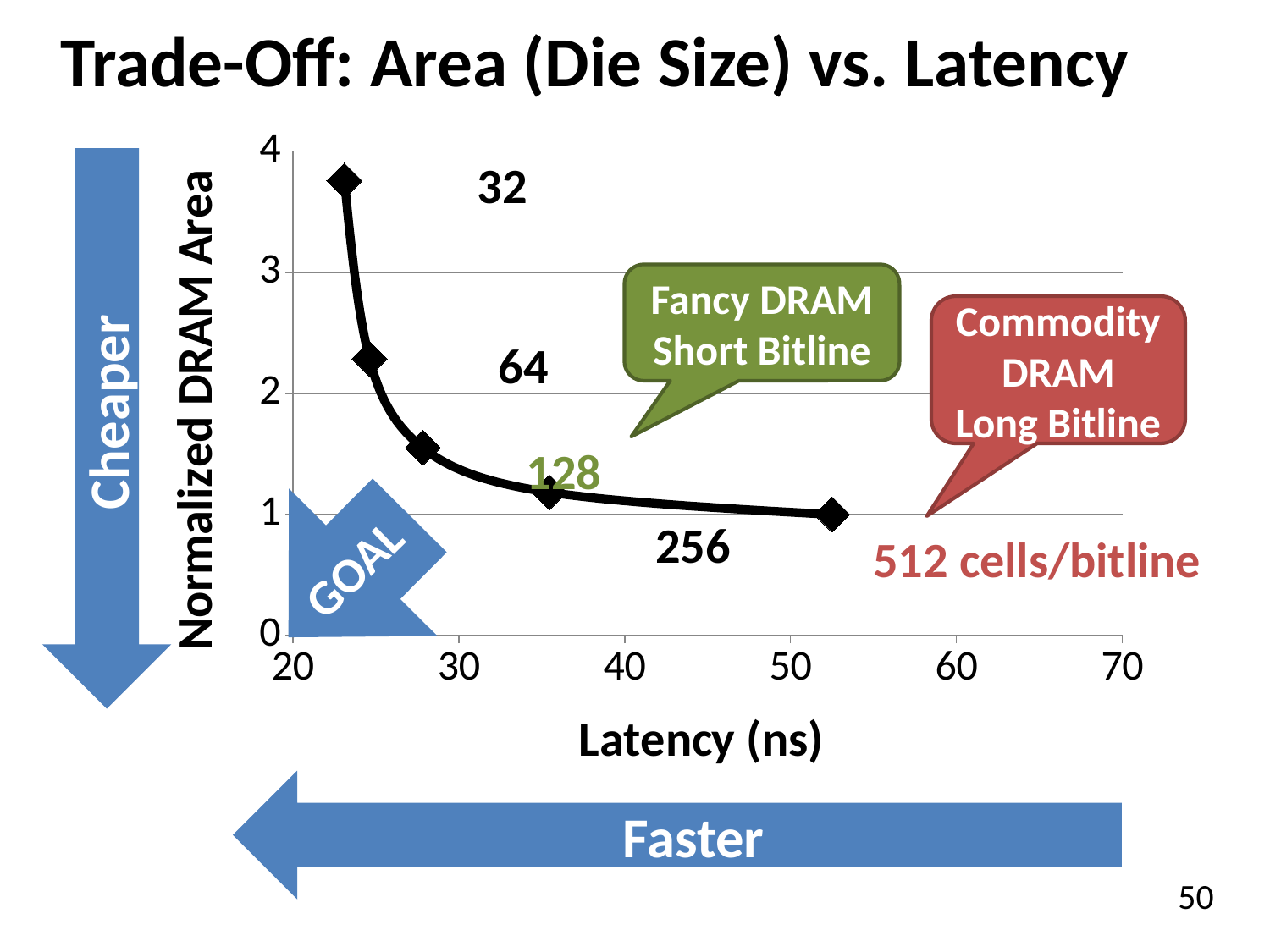
Which cells/bitline configuration has the lowest latency? 32 Which cells/bitline configuration has the highest latency? 512 What is the title of the chart on the slide? Trade-Off: Area (Die Size) vs. Latency As latency increases along the x axis, does the normalized DRAM area rise or fall? fall Is the normalized DRAM area for 64 cells/bitline greater or less than 2? greater Is the latency for 512 cells/bitline greater or less than 50 ns? greater Which cells/bitline configuration has the lowest normalized DRAM area? 512 What is the label of the x axis? Latency (ns) Which cells/bitline configuration has the highest normalized DRAM area? 32 Is the normalized DRAM area for 32 cells/bitline greater or less than 3? greater How many data points are plotted on the curve? 5